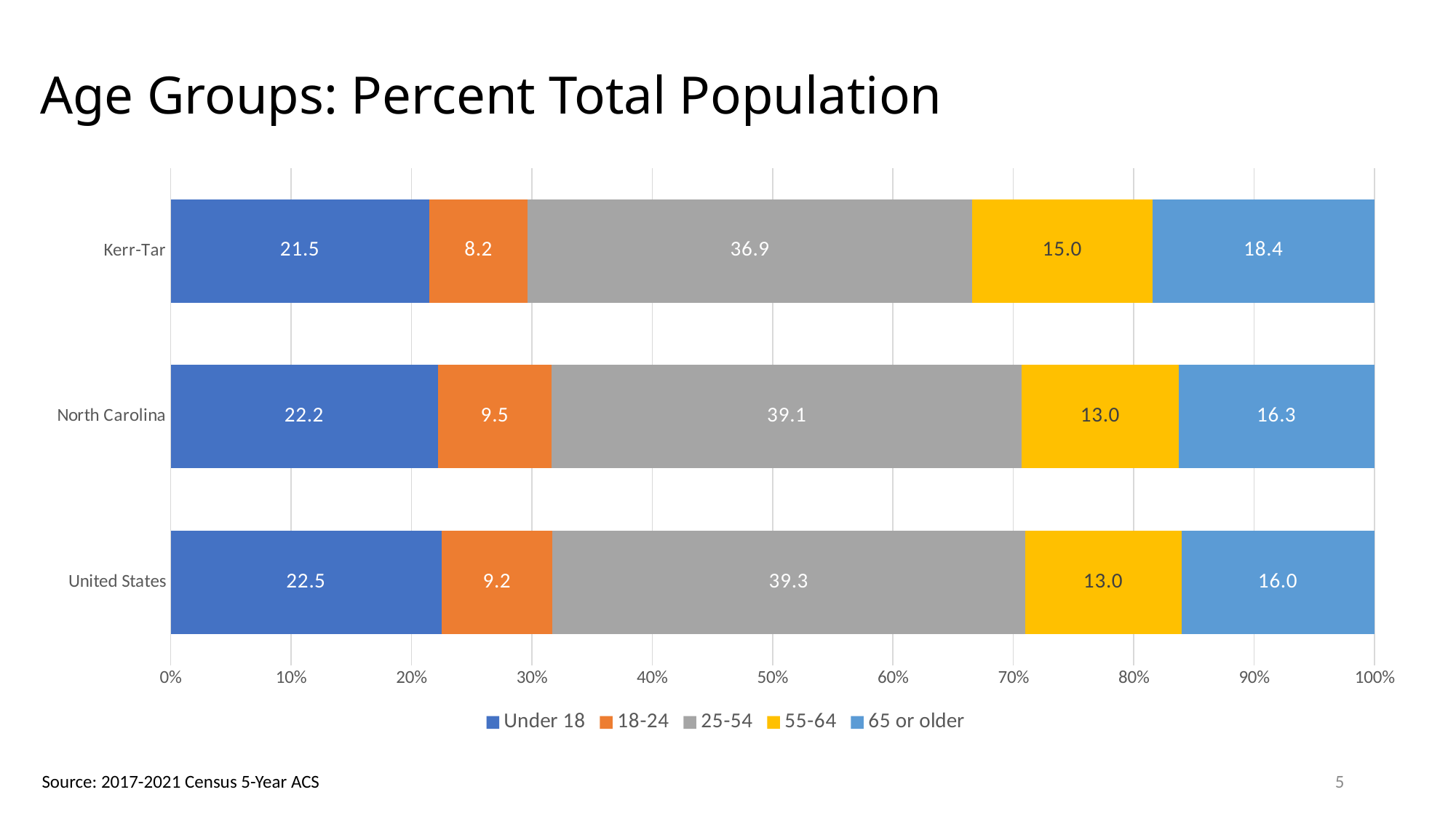
Which region has the lowest value for the 18-24 age group? Kerr-Tar How many age groups does the legend list? 5 Which region has the highest value for the 65 or older age group? Kerr-Tar What is the value for the 18-24 age group in the United States? 9.2 What is the difference between the 25-54 values for the United States and Kerr-Tar? 2.4 What is the value for the 25-54 age group in Kerr-Tar? 36.9 What is the title of the chart? Age Groups: Percent Total Population Which is larger: the Under 18 value for North Carolina or for Kerr-Tar? North Carolina What kind of chart is shown on the slide? Stacked bar chart What is the value for the 65 or older age group in North Carolina? 16.3 What is the total of the stacked bar for Kerr-Tar? 100.0 How many regions are shown on the chart? 3